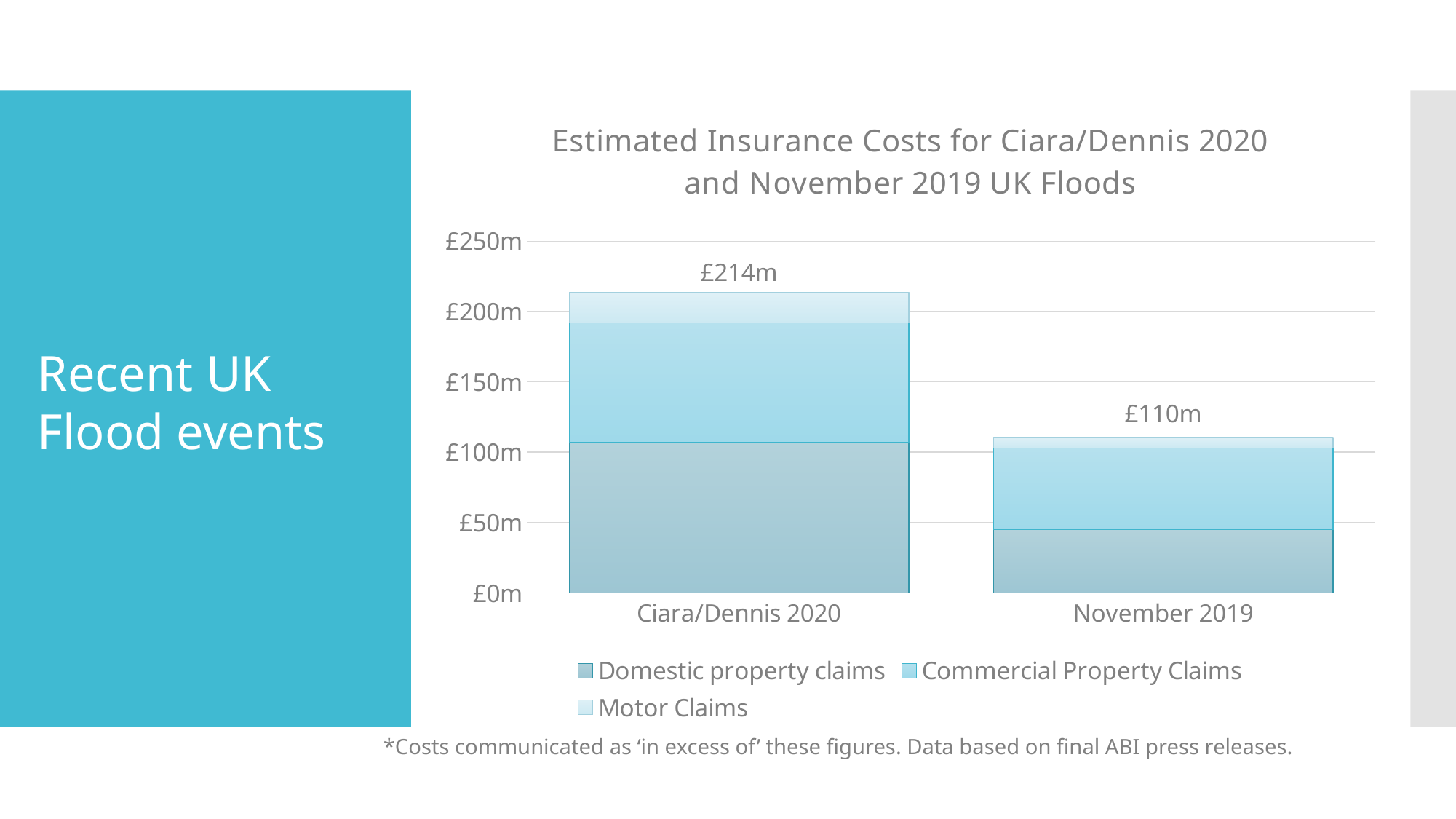
What kind of chart is shown on the slide? Stacked bar chart Which flood event has the lower total estimated insurance cost? November 2019 How many series does the legend list? 3 Is the total for Ciara/Dennis 2020 larger or smaller than the total for November 2019? larger What is the total estimated insurance cost for November 2019? £110m What is the total estimated insurance cost for Ciara/Dennis 2020? £214m Which flood event has the higher total estimated insurance cost? Ciara/Dennis 2020 How many flood events are shown on the x axis? 2 Is the value for Domestic property claims for November 2019 greater or less than £100m? less Which series is shown in the lightest shade of blue in the legend? Motor Claims What is the difference between the total estimated insurance costs for Ciara/Dennis 2020 and November 2019? £104m Is the value for Domestic property claims for Ciara/Dennis 2020 greater or less than £50m? greater